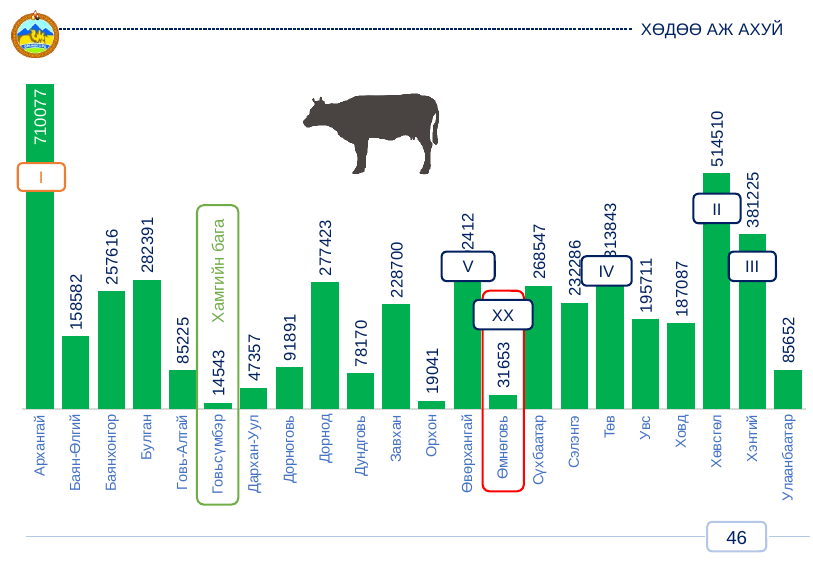
What is the difference between the values for Хөвсгөл and Хэнтий? 133285 Which has a larger value, Дорнод or Завхан? Дорнод Which category is labelled with the green box reading "Хамгийн бага"? Говьсүмбэр What is the difference between the values for Булган and Баянхонгор? 24775 What is the value shown for Орхон? 19041 What is the value shown for Говьсүмбэр? 14543 Which category has the highest value? Архангай What is the value shown for Архангай? 710077 How many categories are shown on the x axis? 22 What kind of chart is shown on the slide? Bar chart What is the value shown for Хөвсгөл? 514510 Which category has the lowest value? Говьсүмбэр